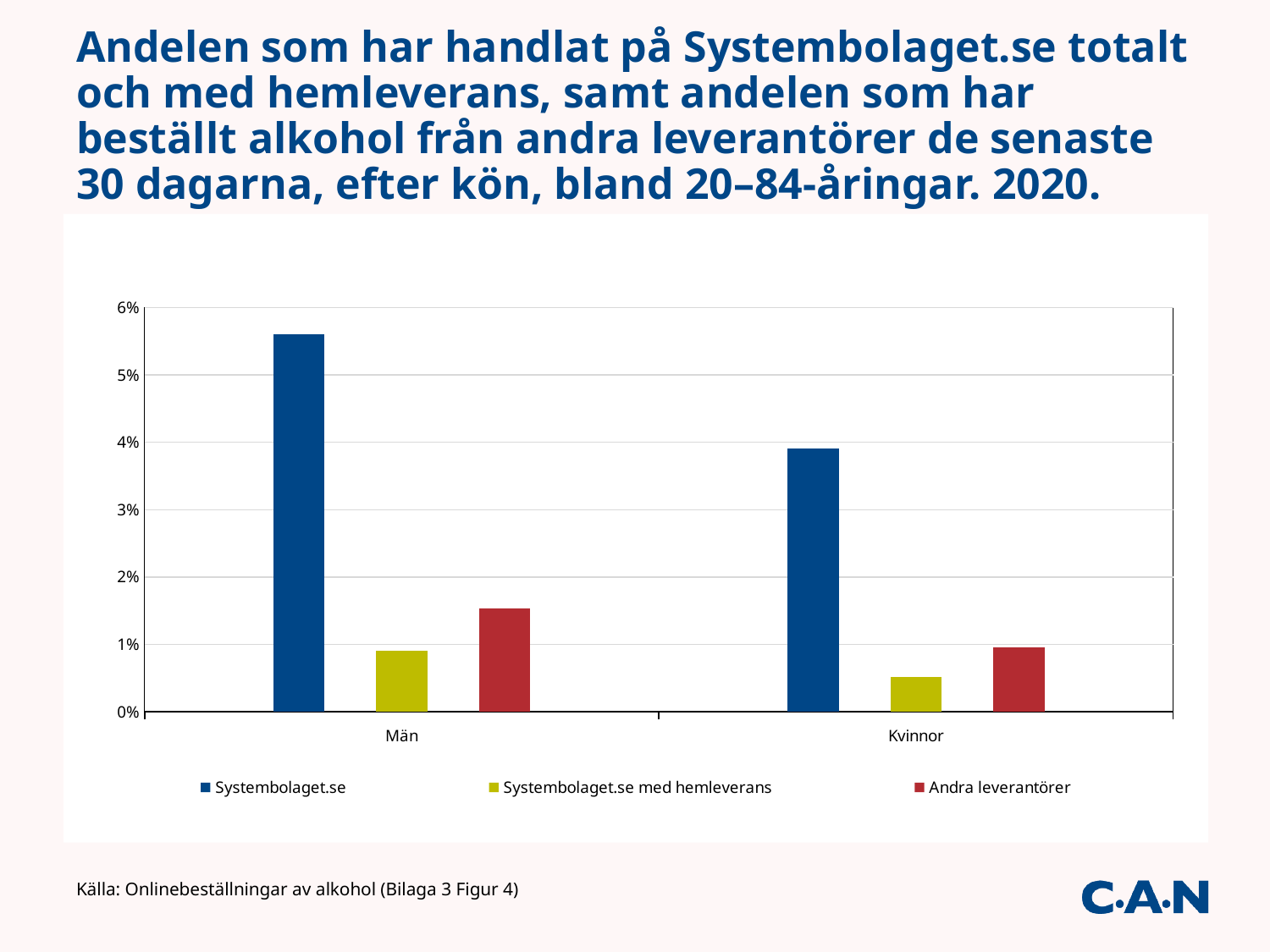
Which series has the highest value among Män? Systembolaget.se Is the value for Systembolaget.se med hemleverans among Kvinnor greater or less than 1%? less Is the value for Systembolaget.se among Män greater or less than 5%? greater What colour are the bars for Andra leverantörer? red How many categories are shown on the x axis? 2 How many series does the legend list? 3 Is the value for Systembolaget.se among Kvinnor greater or less than 3%? greater Which group has the higher value for Systembolaget.se, Män or Kvinnor? Män Which series has the lowest value among Kvinnor? Systembolaget.se med hemleverans What kind of chart is shown on the slide? bar chart Which group has the higher value for Andra leverantörer, Män or Kvinnor? Män